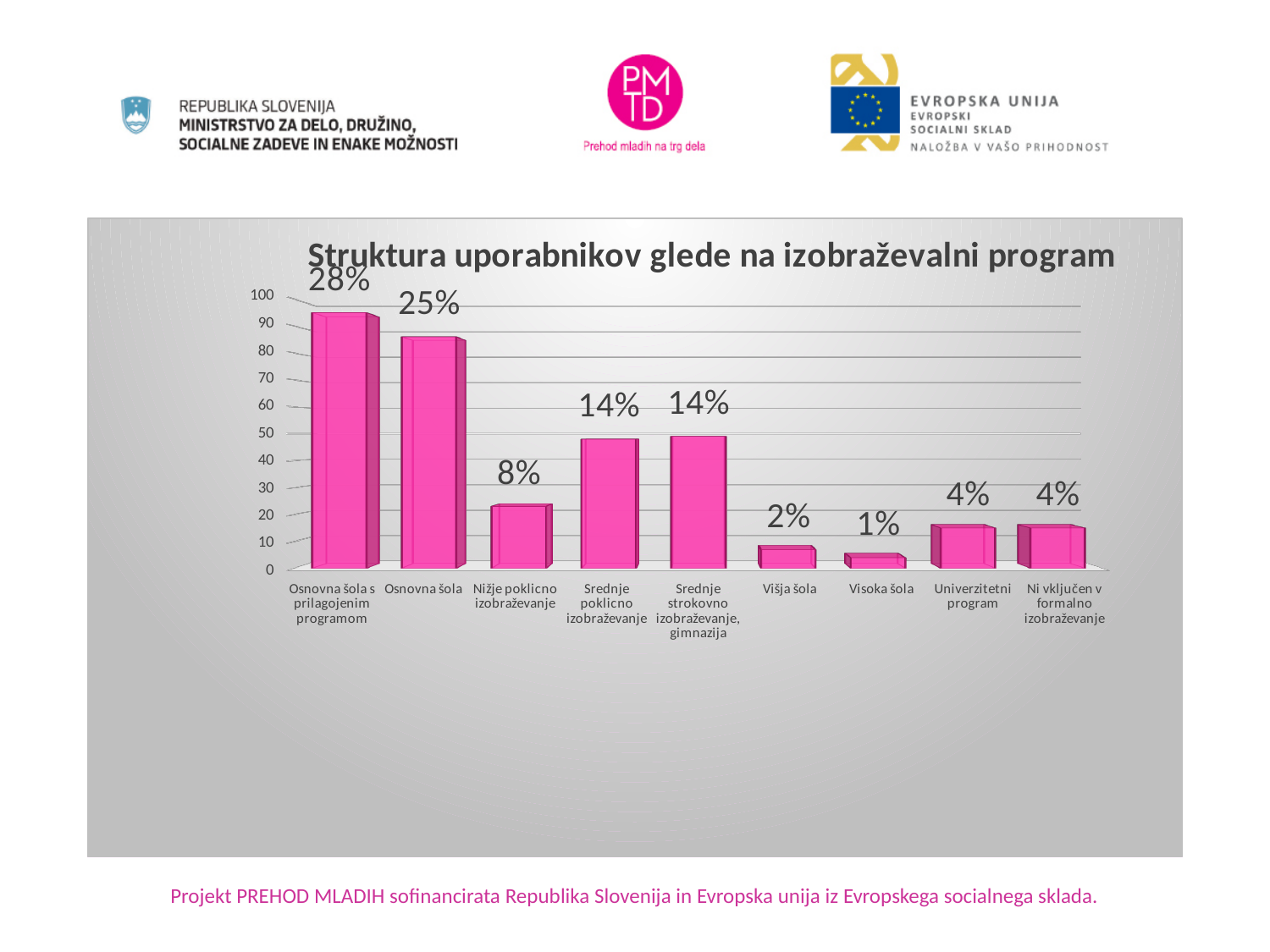
Which is larger, the value for Srednje poklicno izobraževanje or the value for Višja šola? Srednje poklicno izobraževanje What is the data label shown for Visoka šola? 1% How many categories are shown on the x axis? 9 Is the bar for Osnovna šola s prilagojenim programom greater or less than 80 on the vertical axis? greater What is the data label shown for Osnovna šola s prilagojenim programom? 28% What type of chart is shown on the slide? Bar chart Which category has the highest value? Osnovna šola s prilagojenim programom Is the bar for Višja šola greater or less than 10 on the vertical axis? less What is the data label shown for Univerzitetni program? 4% What is the data label shown for Nižje poklicno izobraževanje? 8% What is the difference between the labelled percentages for Osnovna šola s prilagojenim programom and Osnovna šola? 3% Which category has the lowest value? Visoka šola